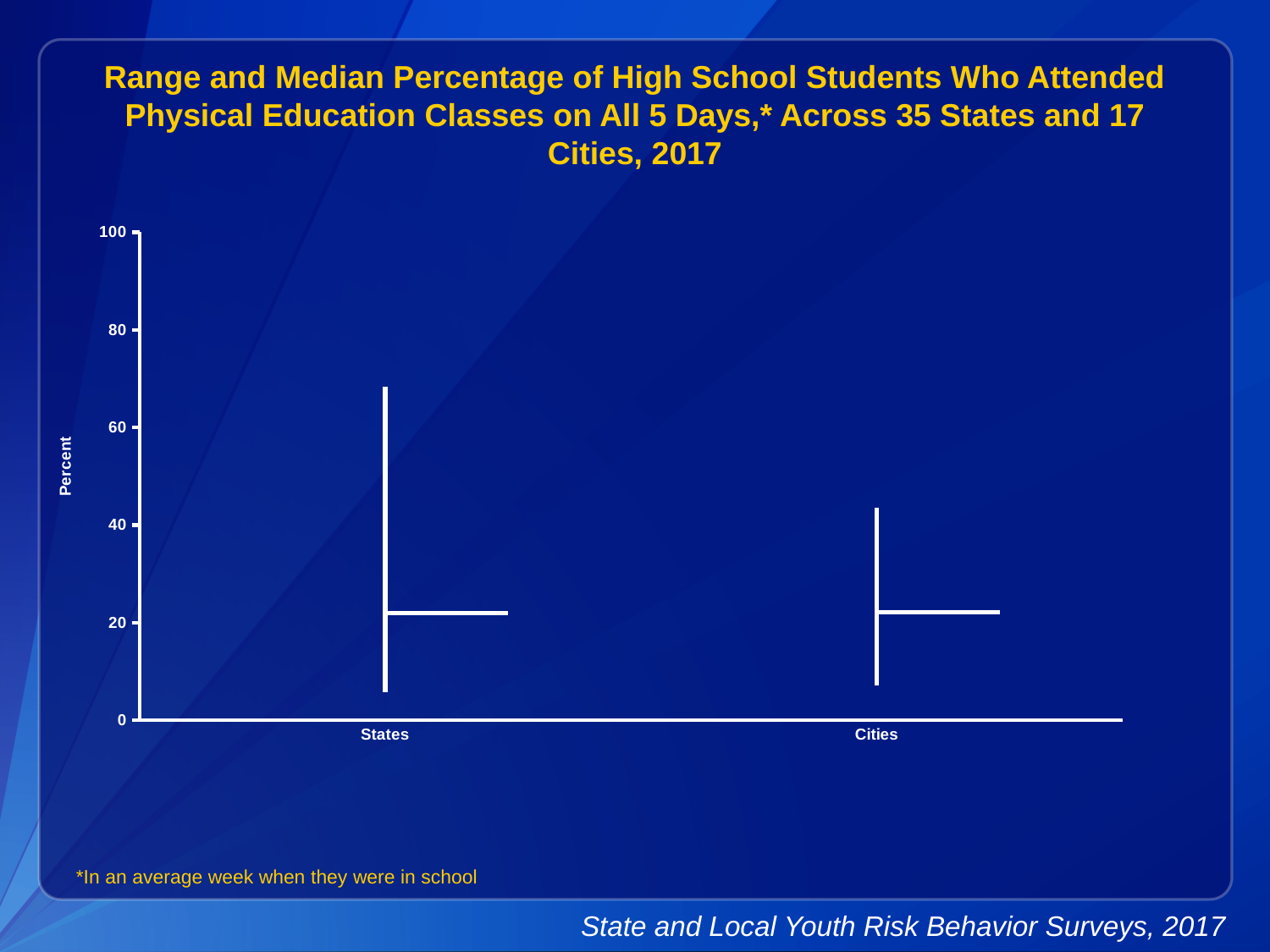
Is the median for Cities greater or less than 40? less Is the bottom of the range for States greater or less than 20? less Which category has the higher top of its range, States or Cities? States Is the bottom of the range for Cities greater or less than 20? less How many categories are shown on the x axis of the chart? 2 What is the label on the y axis of the chart? Percent What is the highest value shown on the y axis? 100 Which category has the widest range? States What are the two categories shown on the x axis? States and Cities